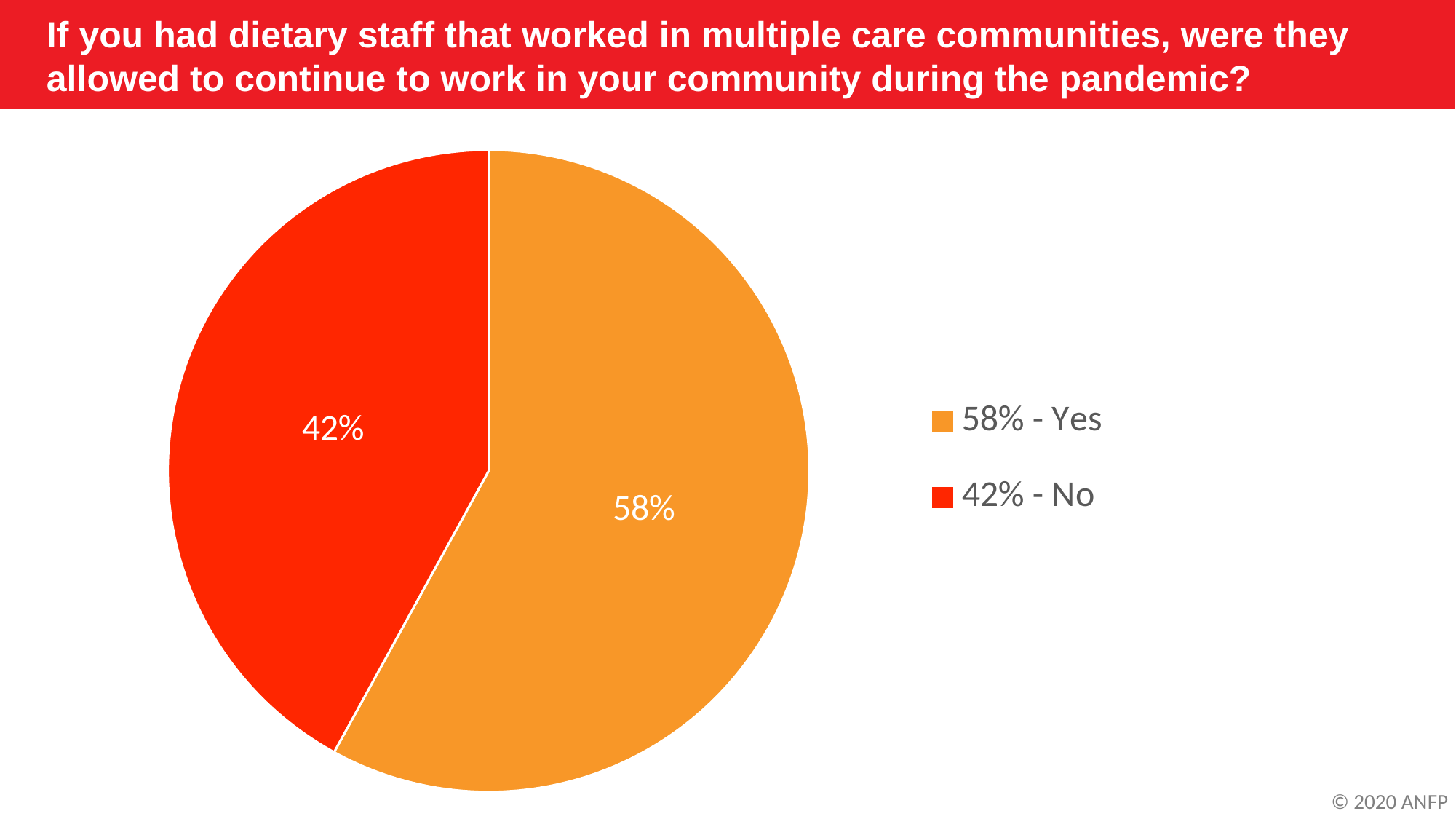
What colour is the Yes slice? orange Which response has the smallest slice of the pie? No What kind of chart is shown on the slide? pie chart What share of the pie is labelled No? 42% What colour is the No slice? red How many slices does the pie chart have? 2 How many entries does the legend list? 2 Which slice is larger, Yes or No? Yes Which response has the largest slice of the pie? Yes Is the share for No greater or less than 50%? less What is the difference in percentage points between the Yes and No slices? 16 What share of the pie is labelled Yes? 58%